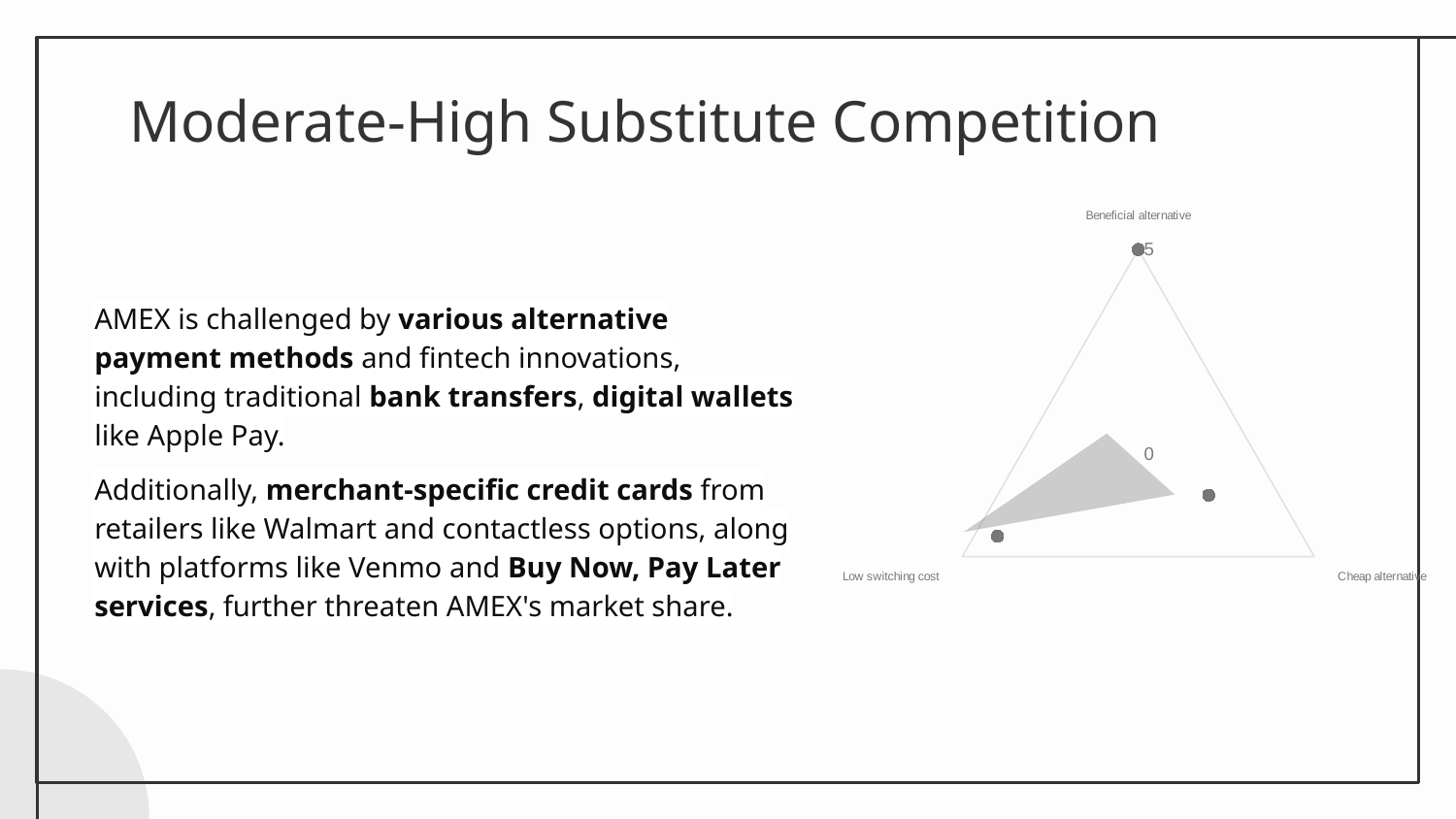
On the radar chart, which plotted point is larger: Low switching cost or Cheap alternative? Low switching cost What are the three category labels on the radar chart? Beneficial alternative, Low switching cost, Cheap alternative What value does the plotted point for Beneficial alternative land on? 5 What is the maximum value shown on the radar chart's axis scale? 5 Which category on the radar chart has the highest plotted point? Beneficial alternative Which category on the radar chart has the lowest plotted point? Cheap alternative How many axes (categories) does the radar chart have? 3 On the radar chart, which plotted point is larger: Beneficial alternative or Cheap alternative? Beneficial alternative What kind of chart is shown on the right of the slide? Radar chart